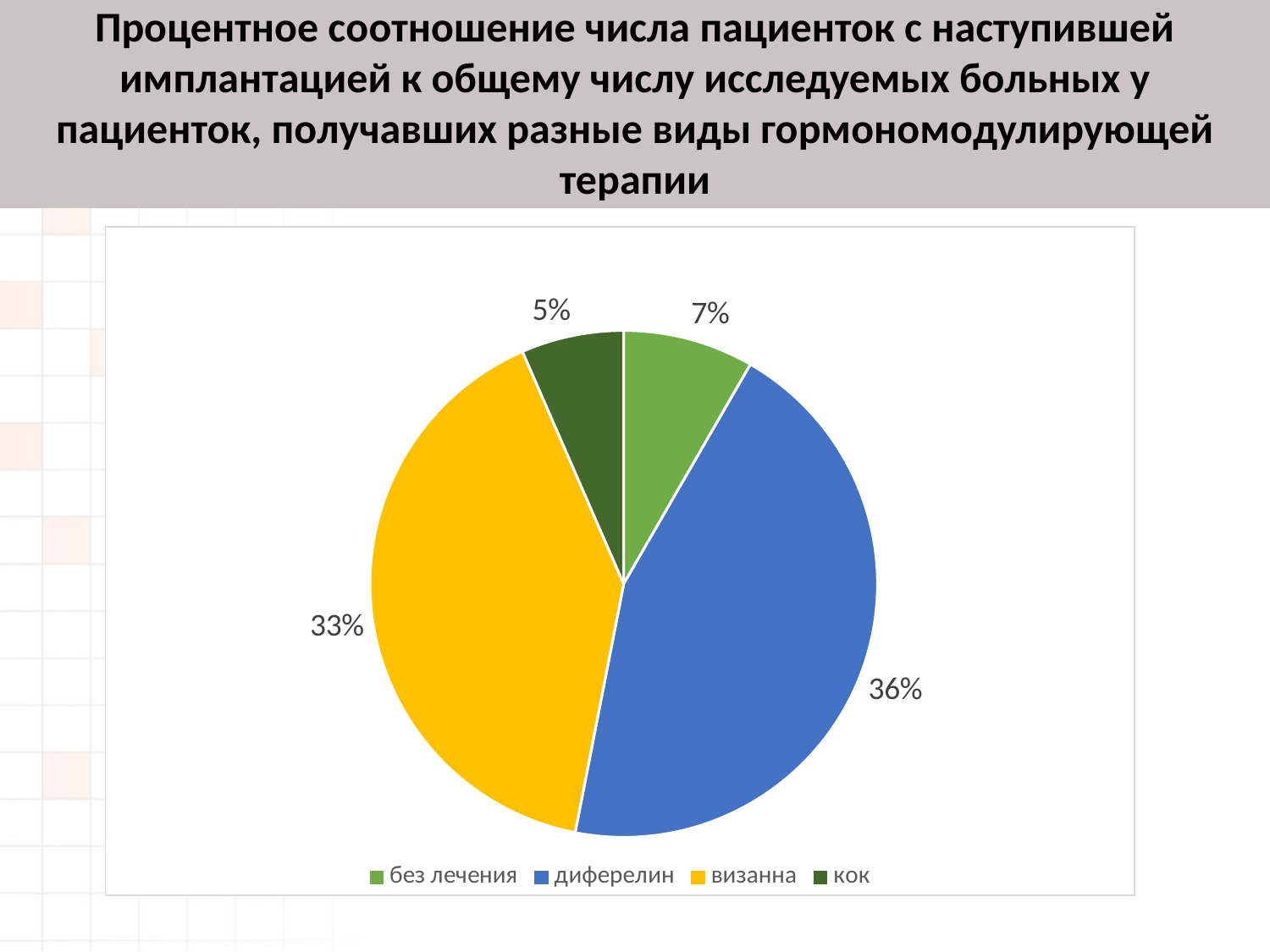
What percentage is shown for the 'визанна' slice? 33% What percentage is shown for the 'без лечения' slice? 7% Which slice is larger, 'без лечения' or 'кок'? без лечения Which category has the smallest slice of the pie? кок What percentage is shown for the 'диферелин' slice? 36% What is the difference in percentage points between the 'диферелин' and 'визанна' slices? 3 What percentage is shown for the 'кок' slice? 5% What kind of chart is shown on the slide? pie chart What colour is the 'визанна' slice? yellow How many entries does the legend list? 4 How many slices does the pie chart have? 4 Which category has the largest slice of the pie? диферелин